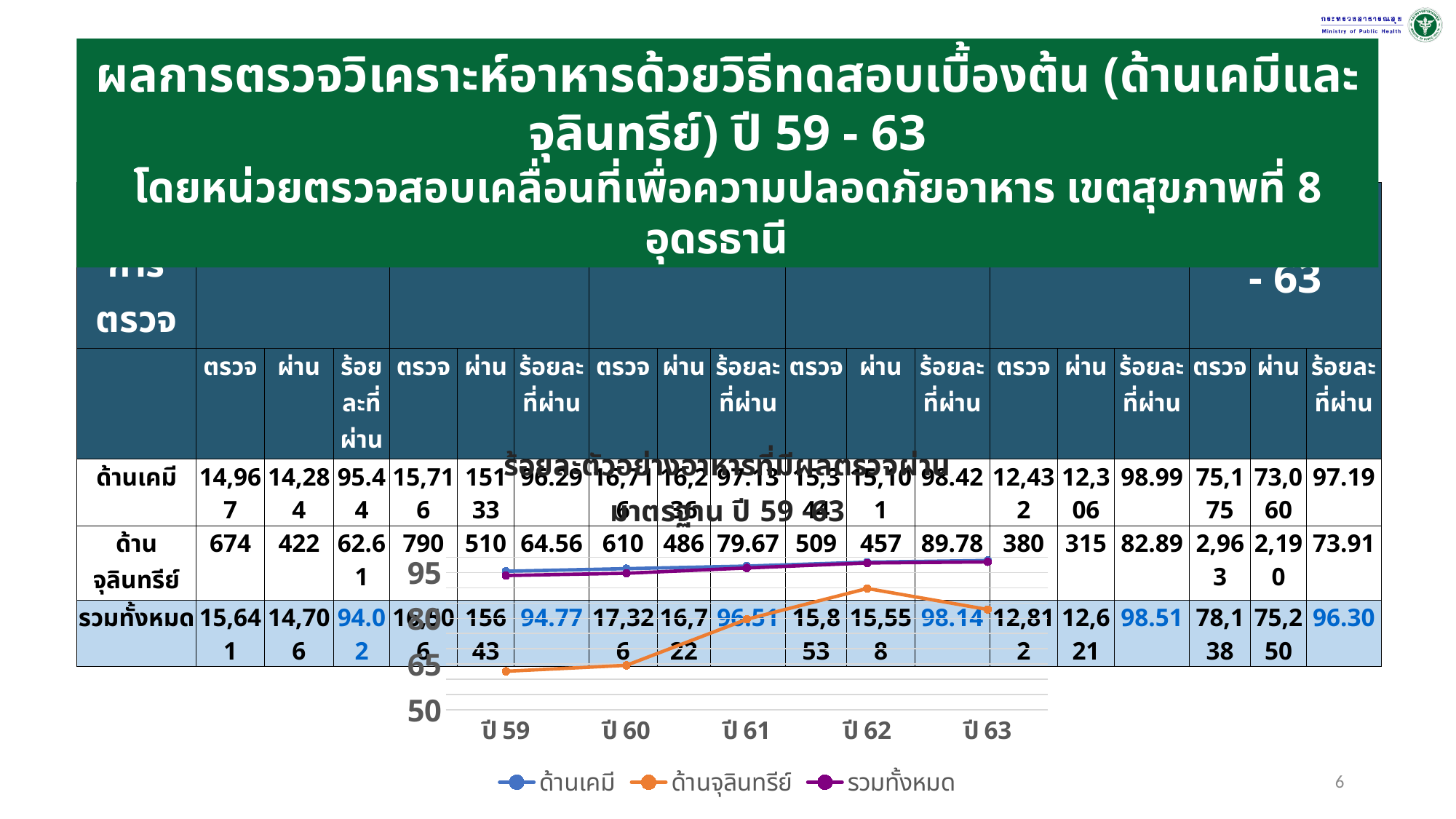
Is the value for ด้านจุลินทรีย์ in ปี 59 greater or less than 80? less What kind of chart is shown on the slide? line chart In which year does the ด้านจุลินทรีย์ series reach its highest value? ปี 62 Does the ด้านจุลินทรีย์ series rise or fall from ปี 59 to ปี 62? rise What is the first category on the x axis of the chart? ปี 59 Is the value for ด้านเคมี in ปี 63 greater or less than 95? greater Which series has the lowest value in ปี 60? ด้านจุลินทรีย์ How many years are plotted along the x axis of the chart? 5 Which series is plotted with the orange line? ด้านจุลินทรีย์ Is the value for ด้านจุลินทรีย์ in ปี 63 greater or less than 65? greater How many series does the chart legend list? 3